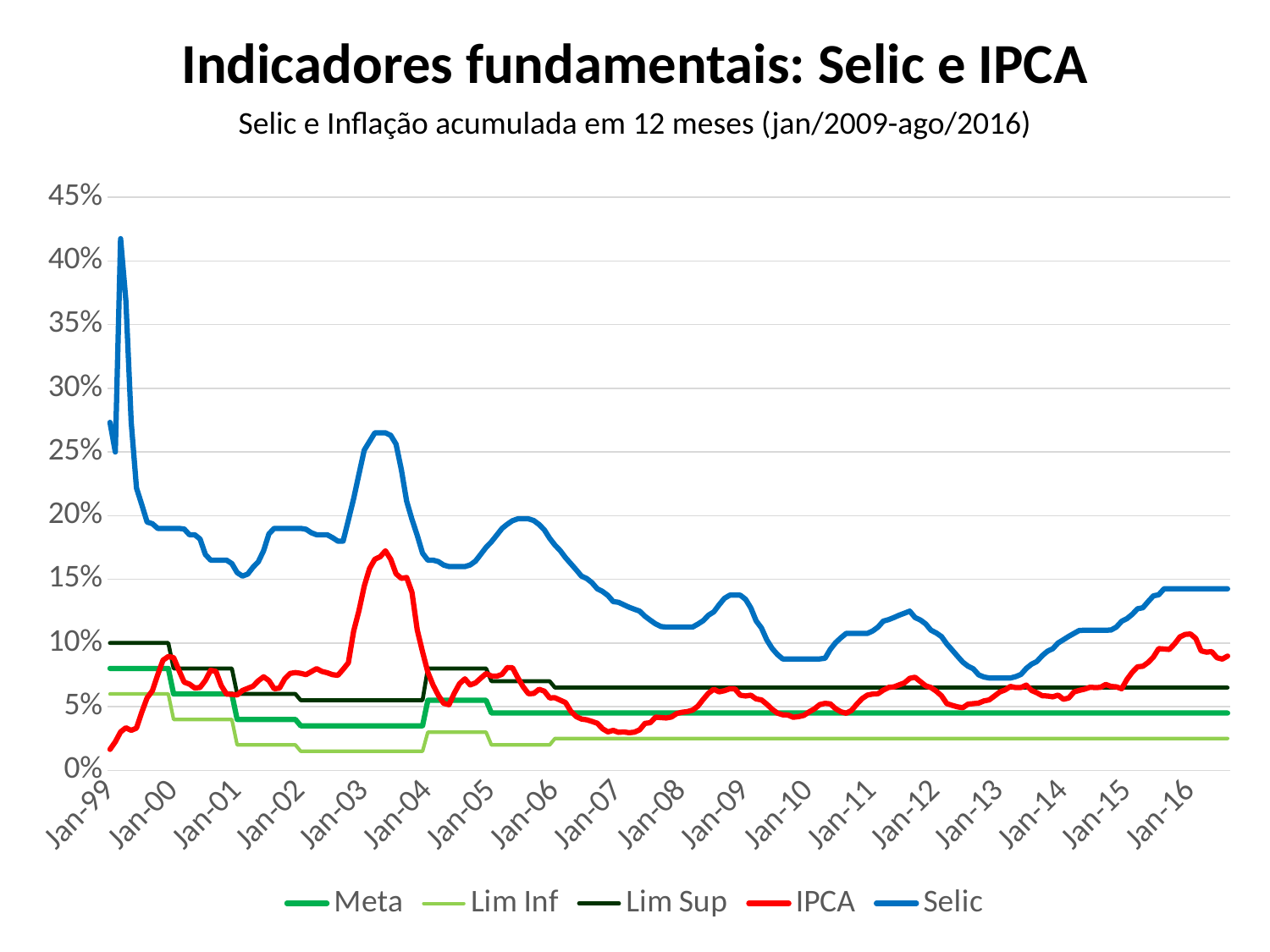
Which series reaches the highest value on the chart? Selic What kind of chart is shown on the slide? line chart How many series does the legend list? 5 Is the peak value of IPCA around 2003 greater or less than 15%? greater Which colour is used for the Selic series? blue What is the title of the chart? Indicadores fundamentais: Selic e IPCA Is the value of IPCA at Jan-07 greater or less than 5%? less Is the peak value of Selic near Jan-99 greater or less than 40%? greater Which series has the lowest values on the chart? Lim Inf Does the Selic series rise or fall between Jan-99 and Jan-00? fall